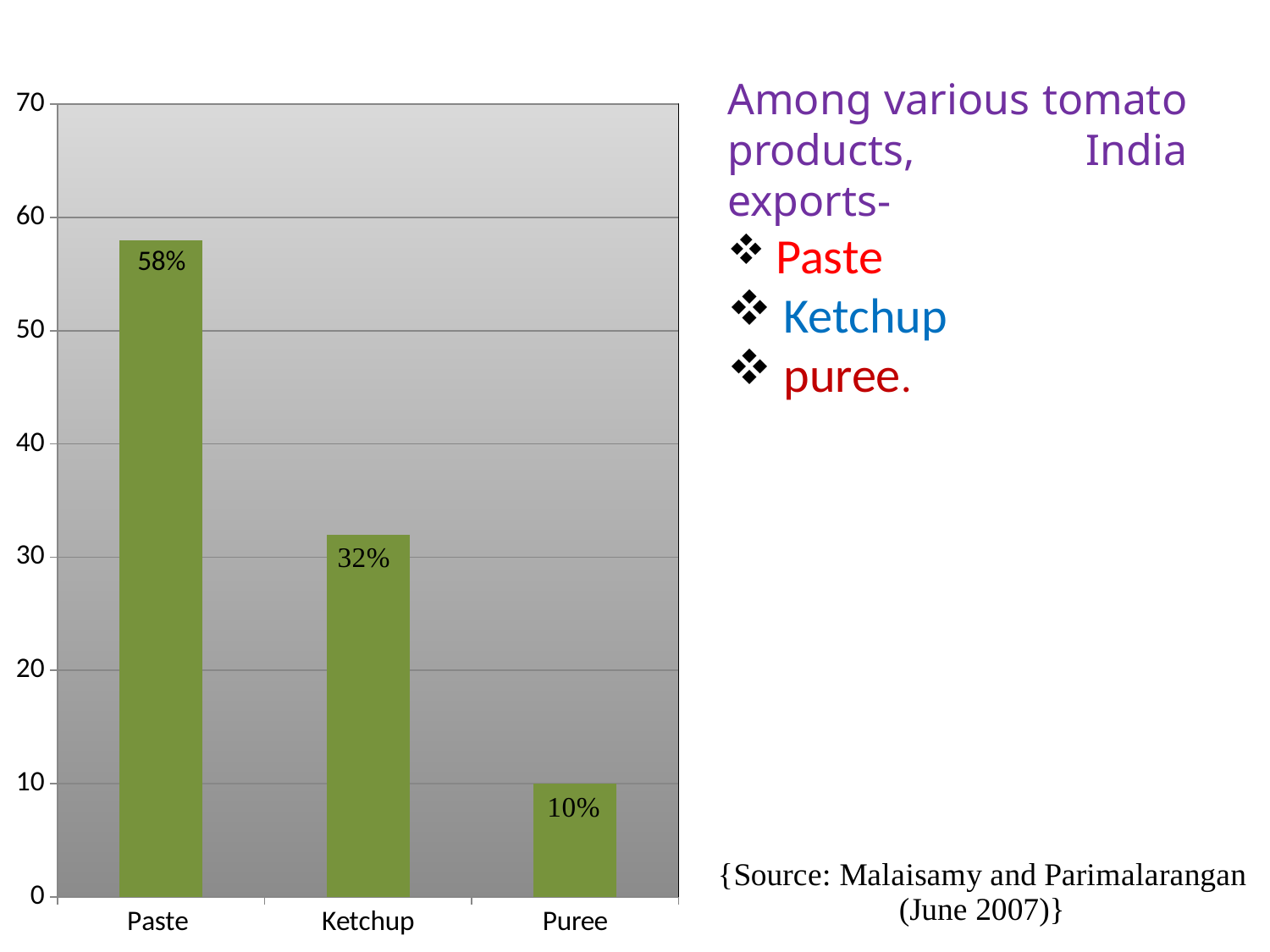
What is the value shown for Ketchup? 32% What is the value shown for Puree? 10% What kind of chart is shown on the slide? bar chart What is the difference between the values for Ketchup and Puree? 22% What is the value shown for Paste? 58% Which category has the lowest value? Puree Which category has the highest value? Paste Which is larger, the value for Ketchup or the value for Puree? Ketchup How many categories are shown on the x axis? 3 What is the difference between the values for Paste and Ketchup? 26% Is the value for Paste greater or less than 50? greater Do the values rise or fall from left to right along the x axis? fall